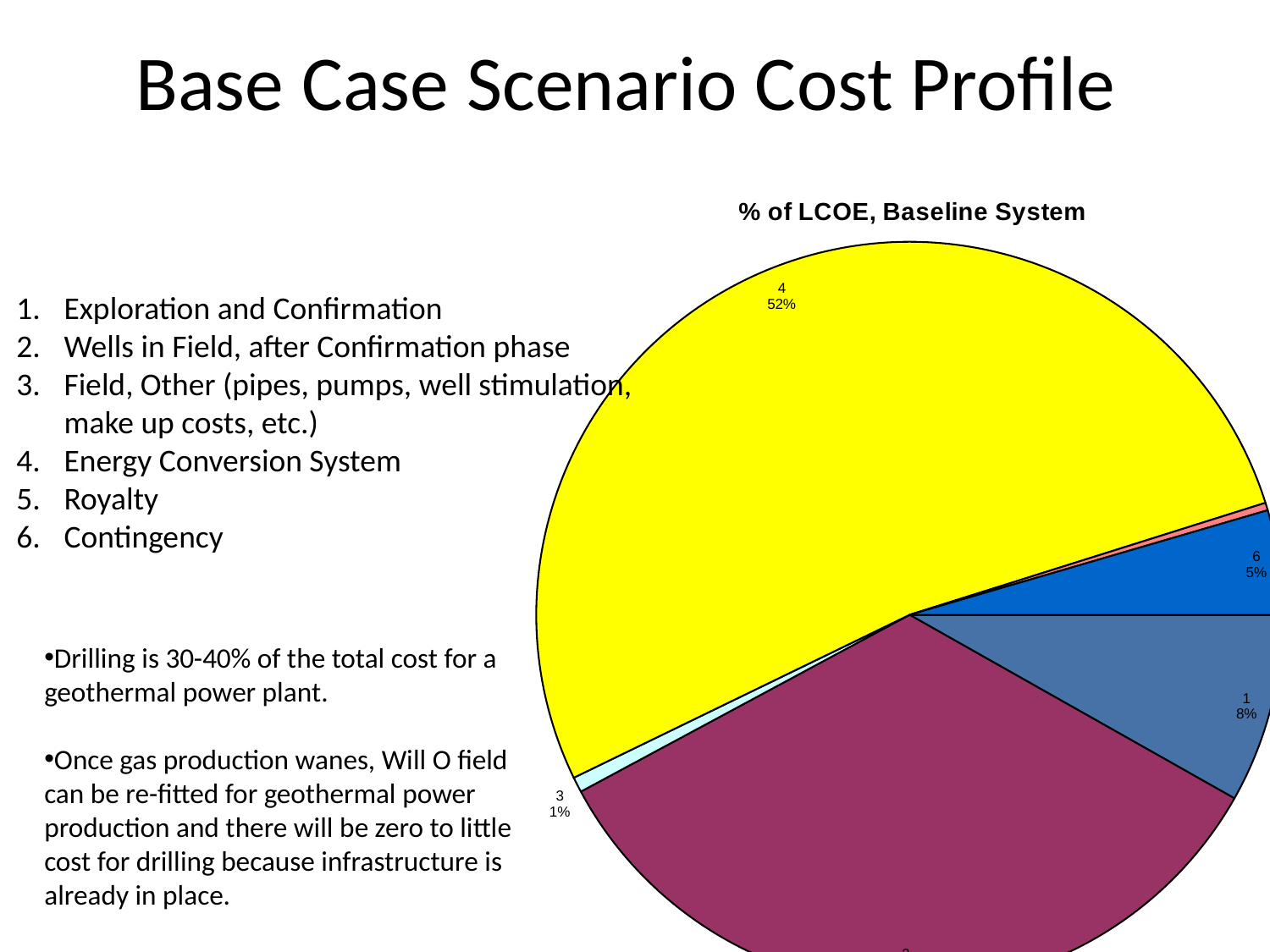
Which slice has the largest share of the pie? 4 What is the title of the chart? % of LCOE, Baseline System How many slices does the pie chart have? 6 What percentage of LCOE does slice 3 represent? 1% What percentage of LCOE does slice 1 represent? 8% What is the difference in percentage points between slice 1 and slice 6? 3 Which is larger, slice 4 or slice 2? slice 4 What is the difference in percentage points between slice 4 and slice 1? 44 What percentage of LCOE does slice 4 represent? 52% Which is larger, slice 1 or slice 6? slice 1 What percentage of LCOE does slice 6 represent? 5% What kind of chart is shown on the slide? pie chart